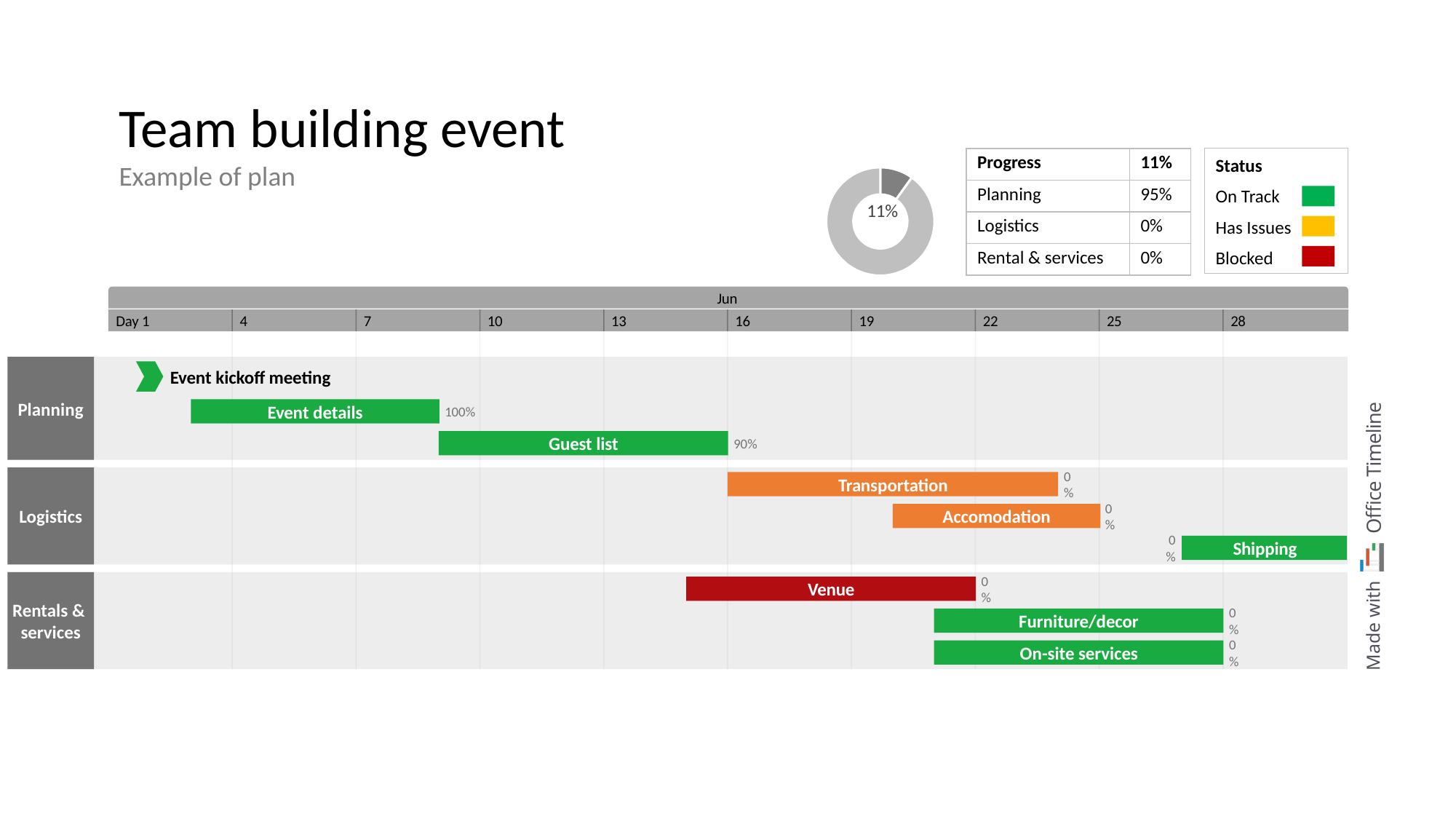
How many task bars are shown in the Rentals & services lane of the timeline chart? 3 Which month does the timeline chart cover? Jun How many swimlane groups (row labels on the left) does the timeline chart have? 3 How many task bars are shown in the Logistics lane of the timeline chart? 3 In the timeline chart, which task bar is coloured red (Blocked)? Venue In the timeline chart, what progress percentage is shown for the Transportation task? 0% In the timeline chart, what is the difference between the progress of Event details and Guest list? 10% In the timeline chart, what progress percentage is shown for the Guest list task? 90% In the timeline chart, which Planning task has the higher progress, Event details or Guest list? Event details What percentage is shown in the centre of the donut chart at the top right? 11% In the timeline chart, what progress percentage is shown for the Event details task? 100% What kind of chart is the small chart at the top right of the slide? Donut chart